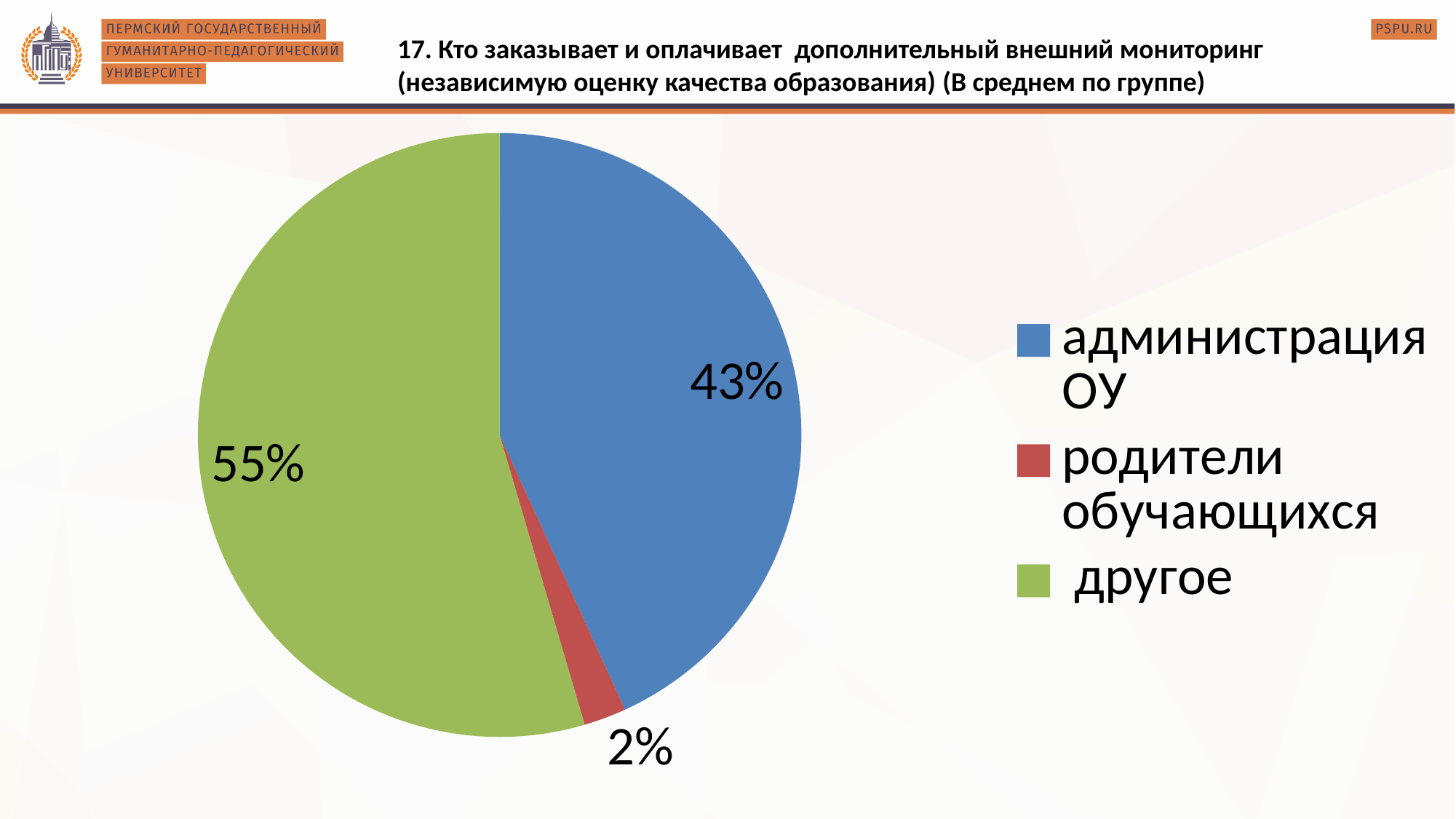
What is the difference in percentage points between "другое" and "администрация ОУ"? 12 Which is larger: the slice for "администрация ОУ" or the slice for "другое"? другое Which category has the largest slice of the pie? другое How many slices does the pie chart have? 3 What share of the pie does "администрация ОУ" hold? 43% What is the difference in percentage points between "администрация ОУ" and "родители обучающихся"? 41 What kind of chart is shown on the slide? pie chart What colour is the slice for "родители обучающихся"? red Which category has the smallest slice of the pie? родители обучающихся What share of the pie does "другое" hold? 55% Which legend entry is shown in green? другое What share of the pie does "родители обучающихся" hold? 2%